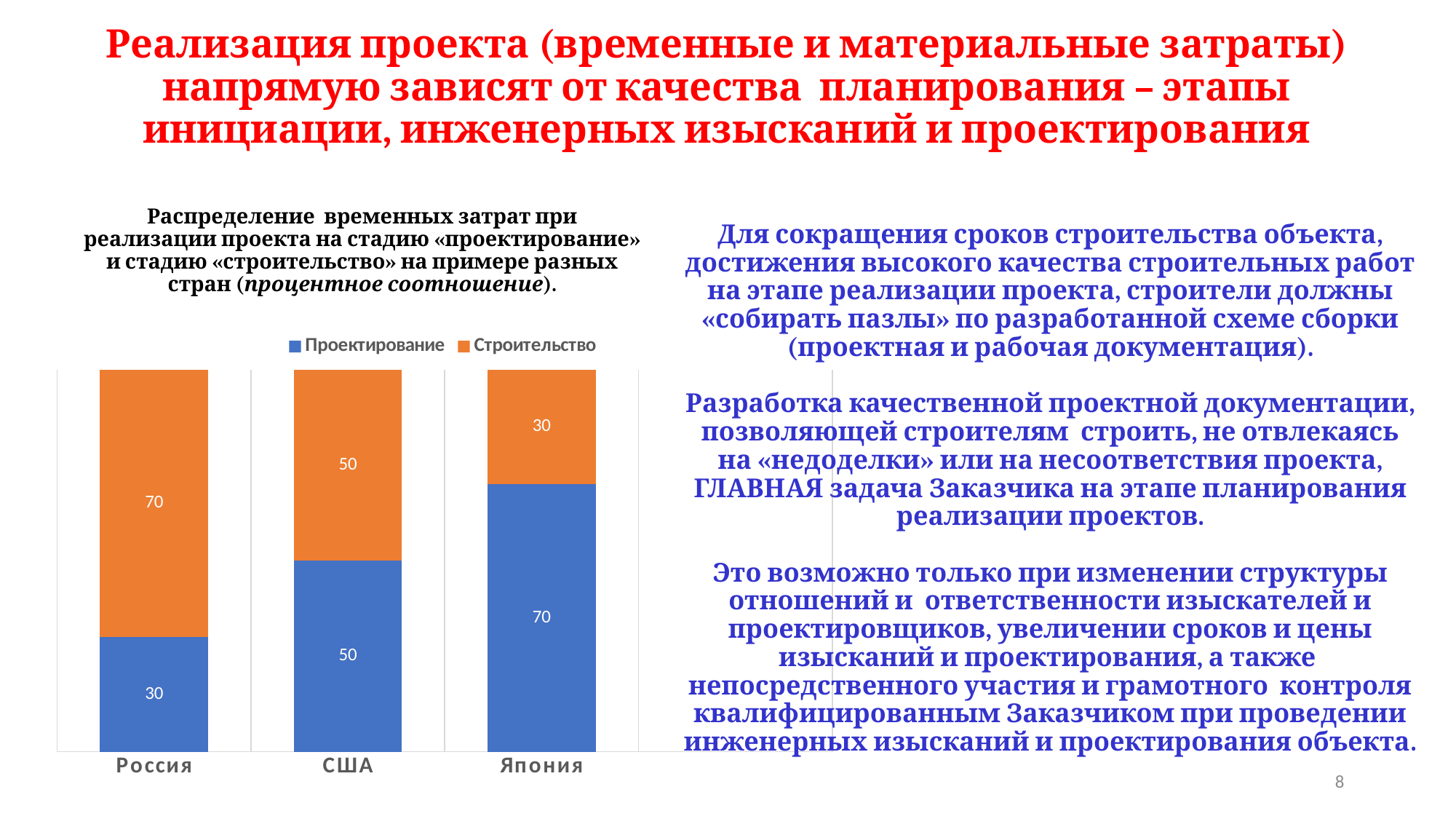
What is the value for Проектирование for Япония? 70 What kind of chart is shown on the slide? Stacked bar chart What is the value for Строительство for Япония? 30 Which country has the lowest value for Строительство? Япония Which is larger: the Проектирование value for Россия or for США? США What is the value for Строительство for США? 50 Which country has the highest value for Проектирование? Япония How many series does the legend list? 2 What is the value for Проектирование for Россия? 30 What is the total of the stacked bar for Россия? 100 How many countries are shown on the x axis? 3 What is the difference between the Строительство values for Россия and Япония? 40